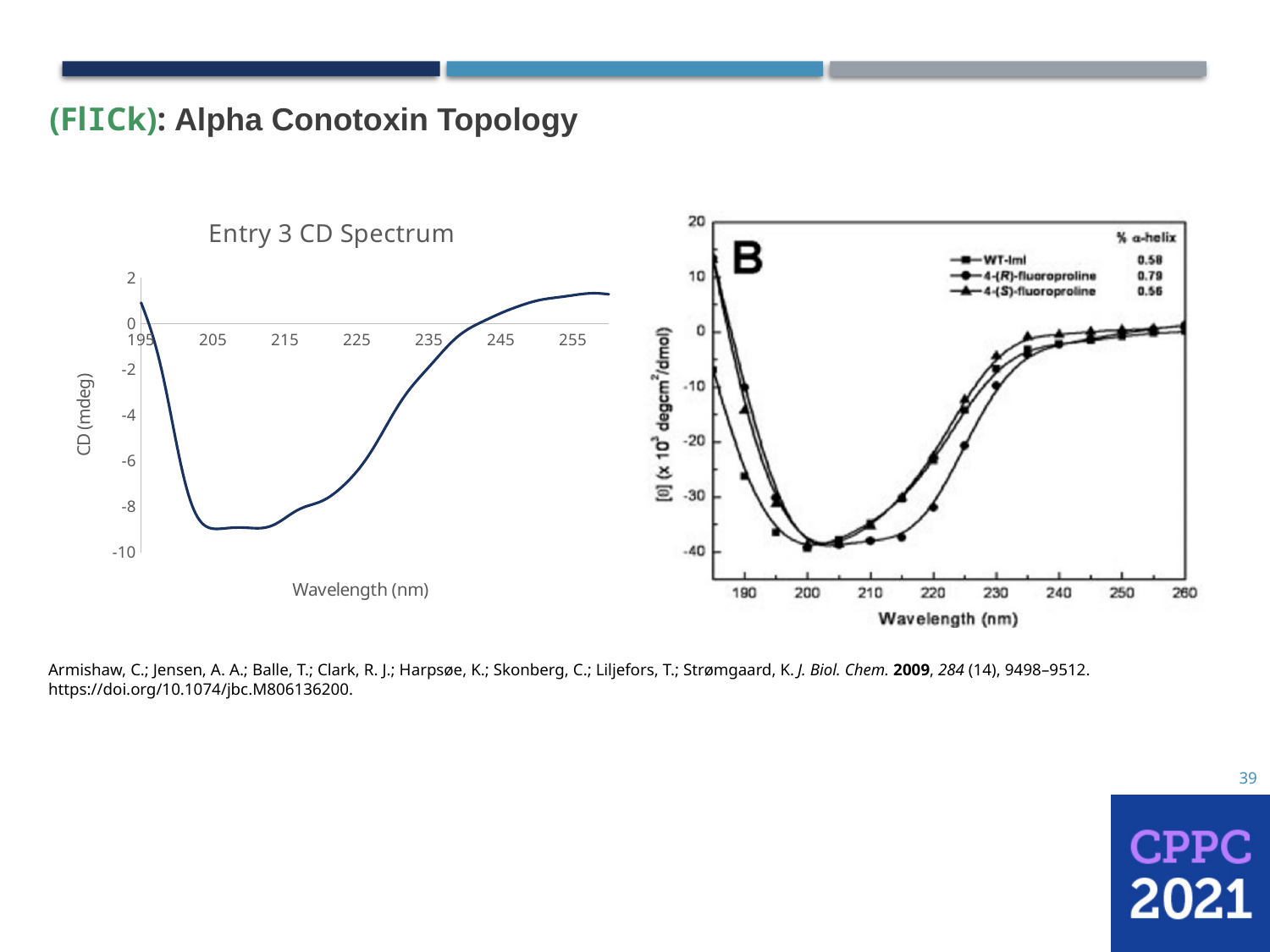
In the right chart (panel B), what % α-helix value is listed for 4-(R)-fluoroproline? 0.79 How many series does the legend of the right chart (panel B) list? 3 What is the title of the left chart? Entry 3 CD Spectrum In the left chart "Entry 3 CD Spectrum", is the value at 205 nm greater or less than -8? less In the right chart (panel B), which series has the highest % α-helix value in the legend? 4-(R)-fluoroproline In the left chart "Entry 3 CD Spectrum", is the value at 255 nm greater or less than 0? greater In the right chart (panel B), which series has the lowest % α-helix value in the legend? 4-(S)-fluoroproline In the left chart "Entry 3 CD Spectrum", does the curve rise or fall between 195 nm and 205 nm? fall In the right chart (panel B), is the WT-ImI value at 200 nm greater or less than -30? less In the left chart "Entry 3 CD Spectrum", does the curve rise or fall between 225 nm and 245 nm? rise In the left chart "Entry 3 CD Spectrum", what is the label of the y axis? CD (mdeg) What kind of chart is the left chart titled "Entry 3 CD Spectrum"? Line chart